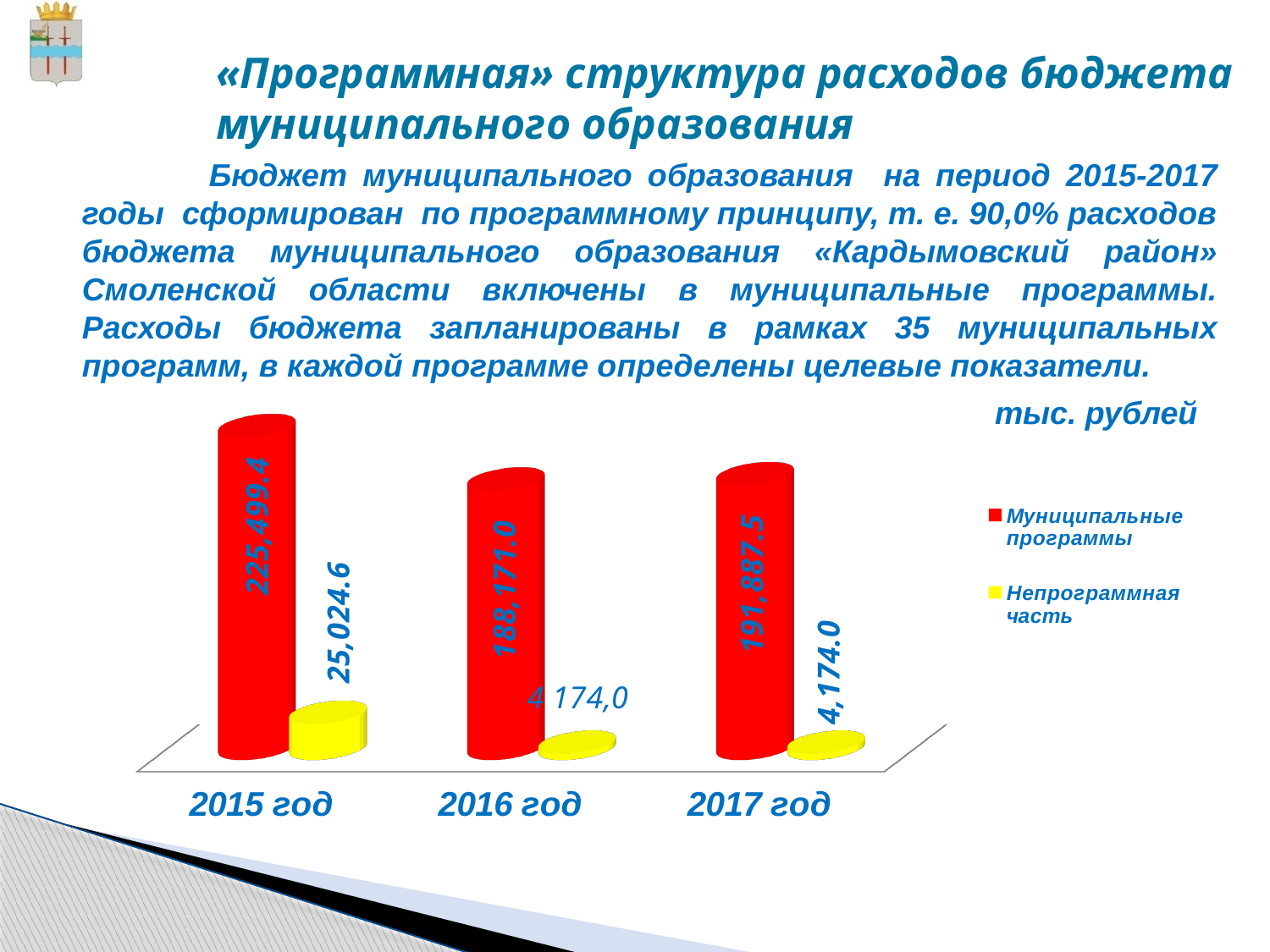
In which year is the value for Муниципальные программы highest? 2015 год In which year is the value for Муниципальные программы lowest? 2016 год What is the value for Муниципальные программы in 2016 год? 188,171.0 How many years are shown on the x axis of the chart? 3 How many series does the chart legend list? 2 What is the difference between the Муниципальные программы values for 2015 год and 2016 год? 37,328.4 What kind of chart is shown on the slide? Bar chart Which is larger, the value for Муниципальные программы in 2017 год or in 2016 год? 2017 год What is the value for Муниципальные программы in 2017 год? 191,887.5 What is the value for Непрограммная часть in 2015 год? 25,024.6 What is the value for Муниципальные программы in 2015 год? 225,499.4 What is the value for Непрограммная часть in 2017 год? 4,174.0